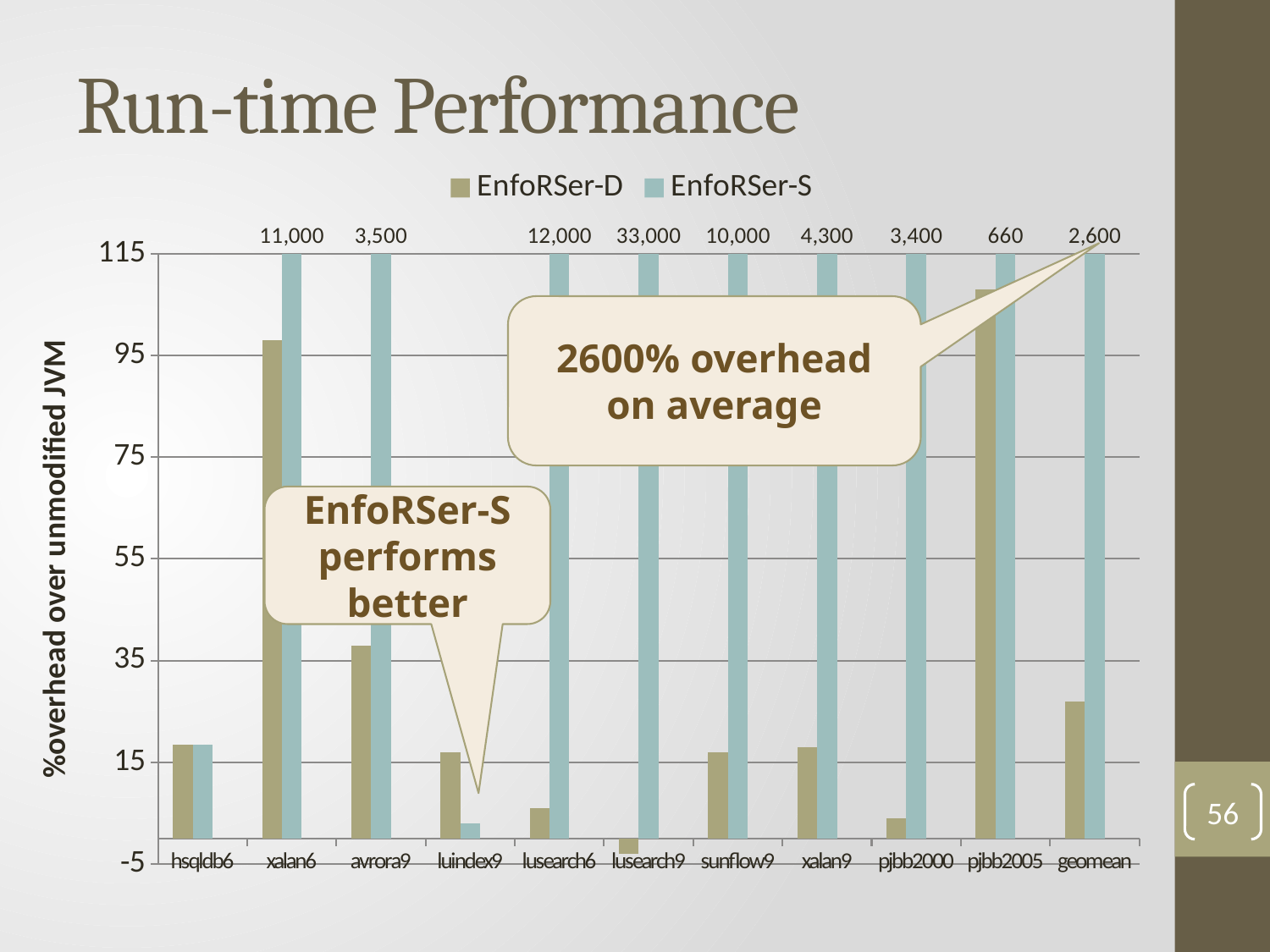
What is the y-axis title of the chart? %overhead over unmodified JVM What value is labeled for EnfoRSer-S on pjbb2005? 660 How many series does the legend list? 2 What is the difference between the labeled EnfoRSer-S values for lusearch9 and lusearch6? 21,000 What value is labeled for EnfoRSer-S on geomean? 2,600 What value is labeled for EnfoRSer-S on lusearch9? 33,000 What kind of chart is shown on the slide? bar chart Which benchmark has the lowest EnfoRSer-D value? lusearch9 How many benchmark categories are shown on the x axis? 11 Is the EnfoRSer-D value for geomean greater or less than 35? less Which is larger for EnfoRSer-D: xalan6 or avrora9? xalan6 Which benchmark has the highest EnfoRSer-S value? lusearch9